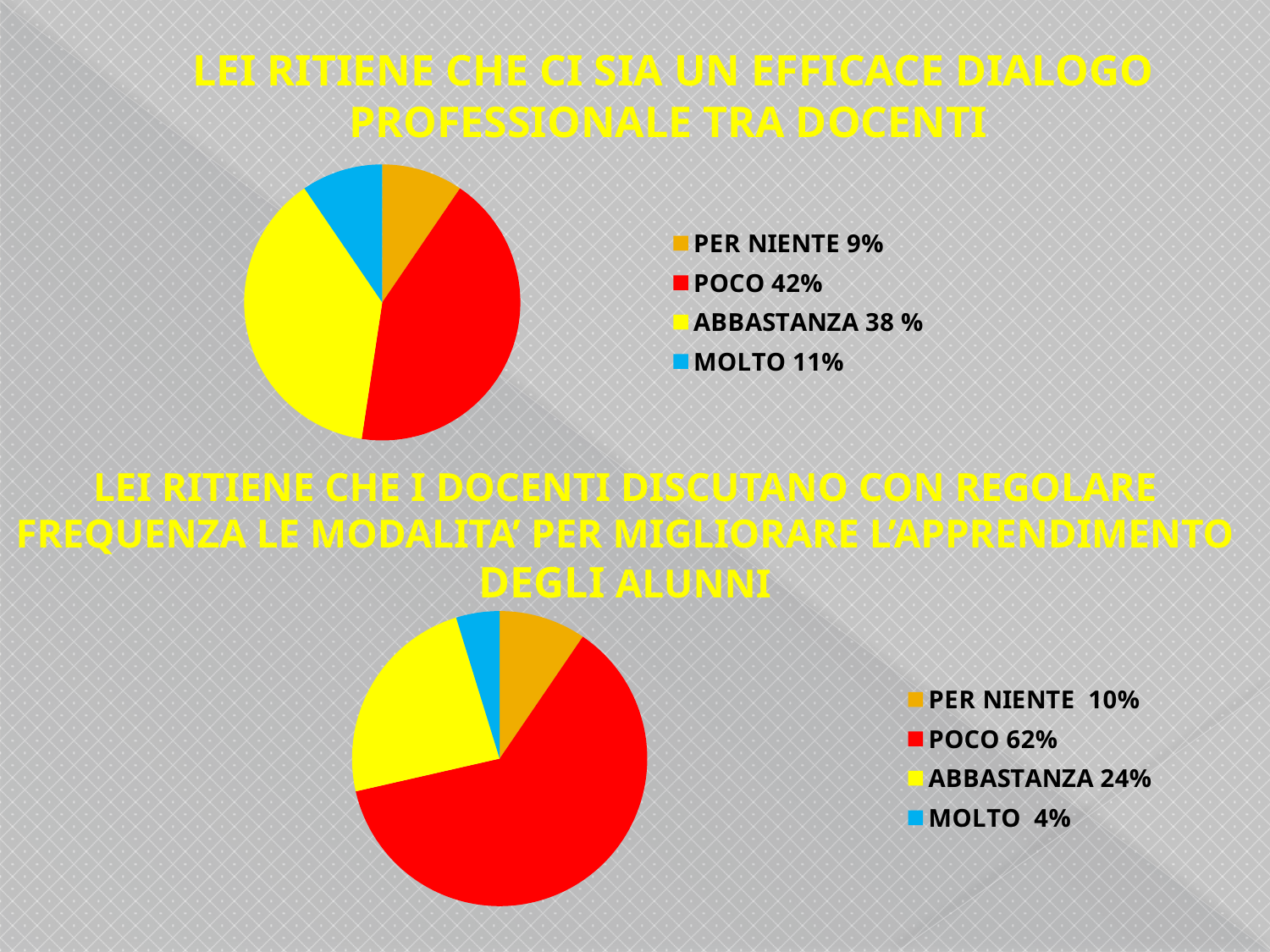
In the top pie chart, what share is shown for MOLTO? 11% In the bottom pie chart, which category has the smallest slice? MOLTO In the bottom pie chart, which category has the largest slice? POCO In the bottom pie chart, what is the difference between the POCO share and the ABBASTANZA share? 38% In the top pie chart, what share is shown for POCO? 42% In the bottom pie chart, what share is shown for MOLTO? 4% In the top pie chart, which category has the largest slice? POCO How many categories does the legend of the bottom pie chart list? 4 What type of chart is used for both charts on the slide? Pie chart Which is larger in the top pie chart: the share for ABBASTANZA or the share for MOLTO? ABBASTANZA In the bottom pie chart, what share is shown for ABBASTANZA? 24%